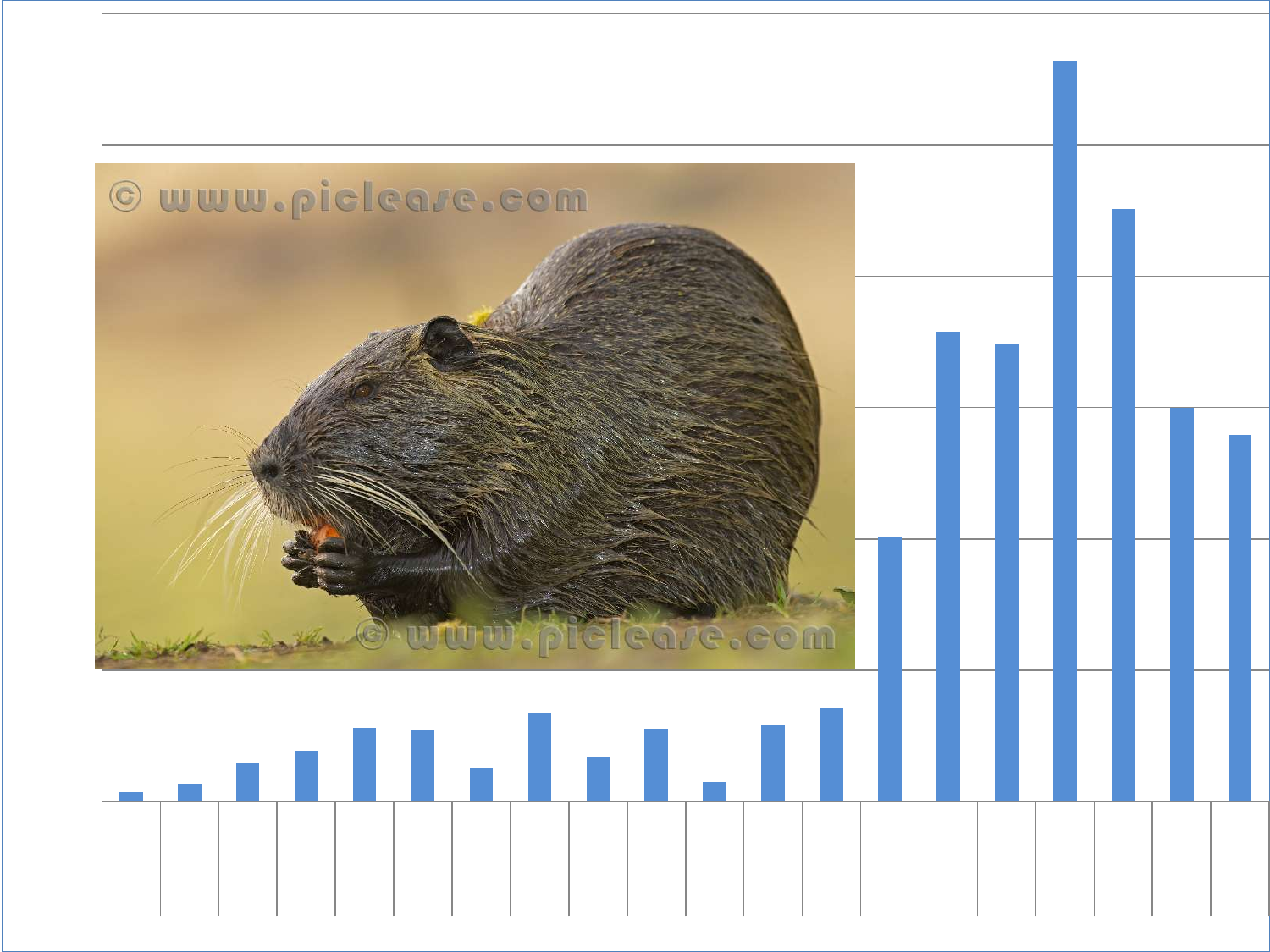
Is the 14th bar from the left taller or shorter than the 13th bar? taller Counting from the left, which bar is the shortest in the chart? the 1st bar Does the chart display a legend? No Is the 17th bar from the left taller or shorter than the 18th bar? taller What kind of chart is shown on the slide? bar chart What colour are the bars in the chart? blue How many bars does the chart contain? 20 Do the bar heights generally rise or fall from left to right across the chart? rise Counting from the left, which bar is the tallest in the chart? the 17th bar